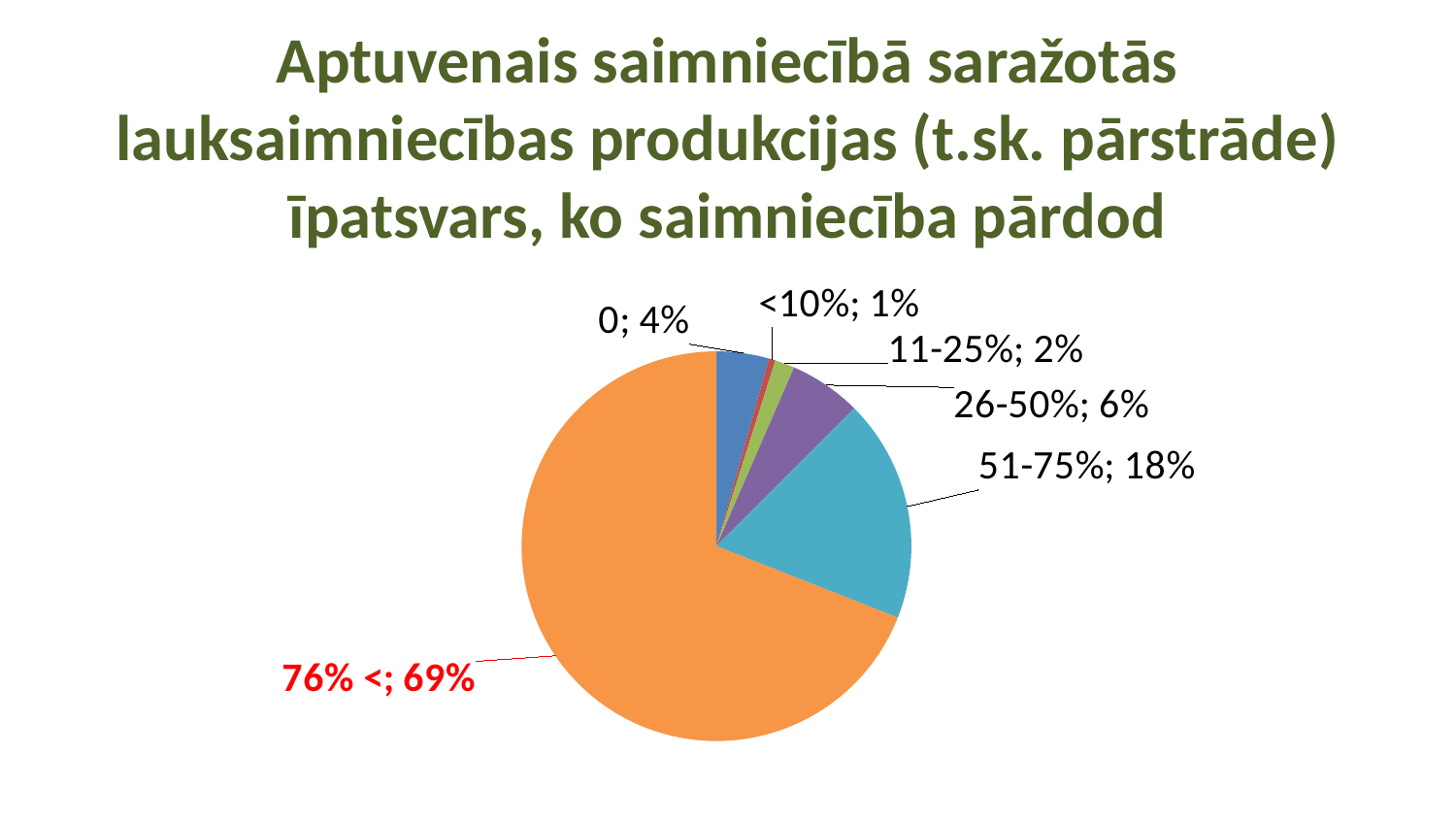
Which category has the smallest slice of the pie? <10% Which is larger, the share for "11-25%" or the share for "26-50%"? 26-50% How many slices does the pie chart have? 6 What share of the pie does the "51-75%" category have? 18% What share of the pie does the "0" category have? 4% What share of the pie does the "<10%" category have? 1% Which slice label is printed in red on the slide? 76% <; 69% What kind of chart is shown on the slide? pie chart Which category has the largest slice of the pie? 76% < What is the difference between the shares of the "76% <" and "51-75%" categories? 51 percentage points